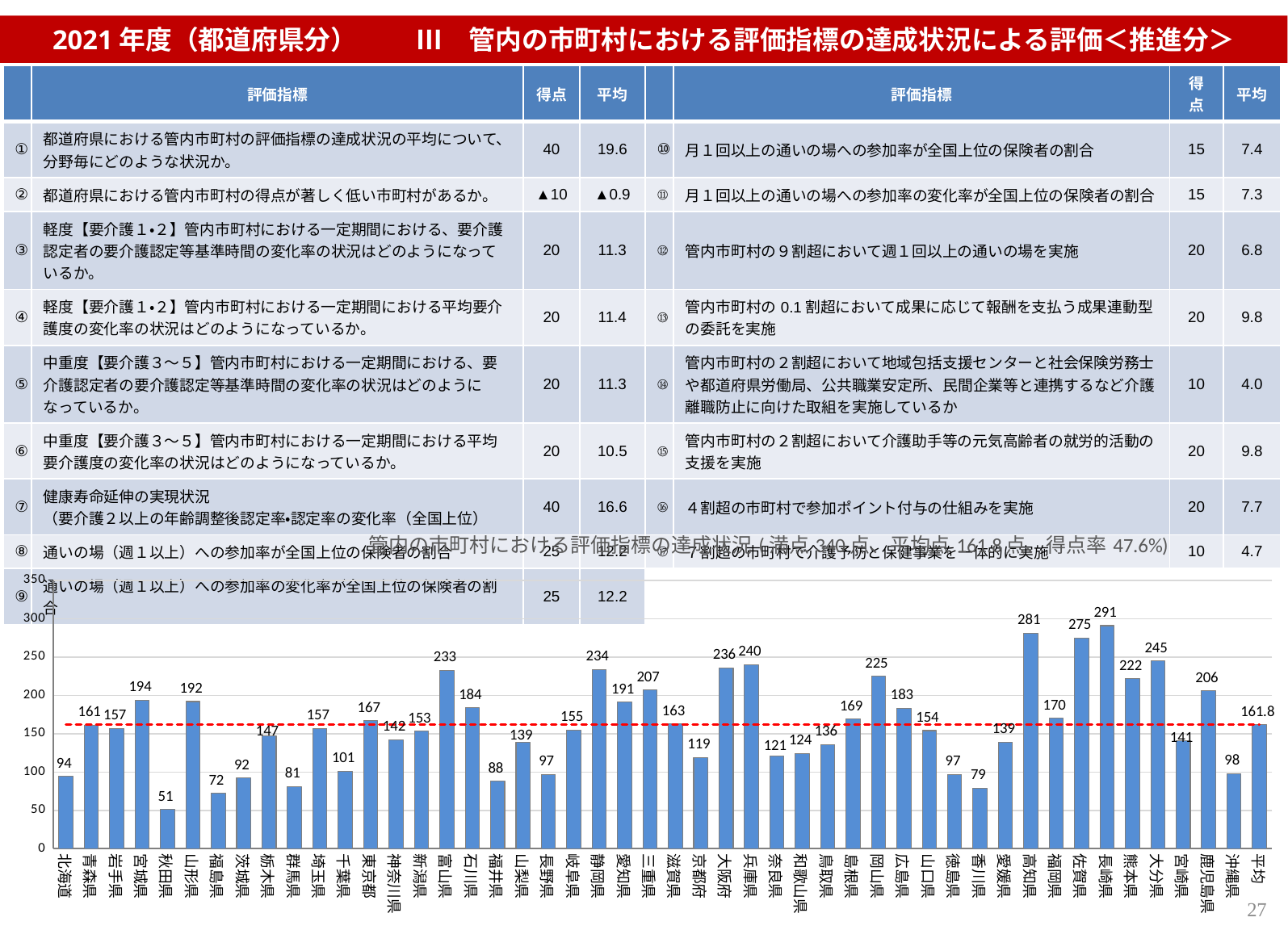
In the bar chart, which has a larger value, 富山県 or 静岡県? 静岡県 According to the chart title, what is the full score (満点) for the evaluation indicators? 340 点 Which prefecture has the lowest value in the bar chart? 秋田県 In the bar chart, what is the value for 兵庫県? 240 According to the chart title, what is the score rate (得点率)? 47.6% Which prefecture has the highest value in the bar chart? 長崎県 In the bar chart, what is the value for 平均 (the last bar)? 161.8 Is the value for 大分県 in the bar chart greater or less than 200? greater What type of chart is shown at the bottom of the slide? bar chart What is the difference between the values for 宮城県 and 秋田県 in the bar chart? 143 In the bar chart, what is the value for 北海道? 94 What is the difference between the values for 高知県 and 福岡県 in the bar chart? 111